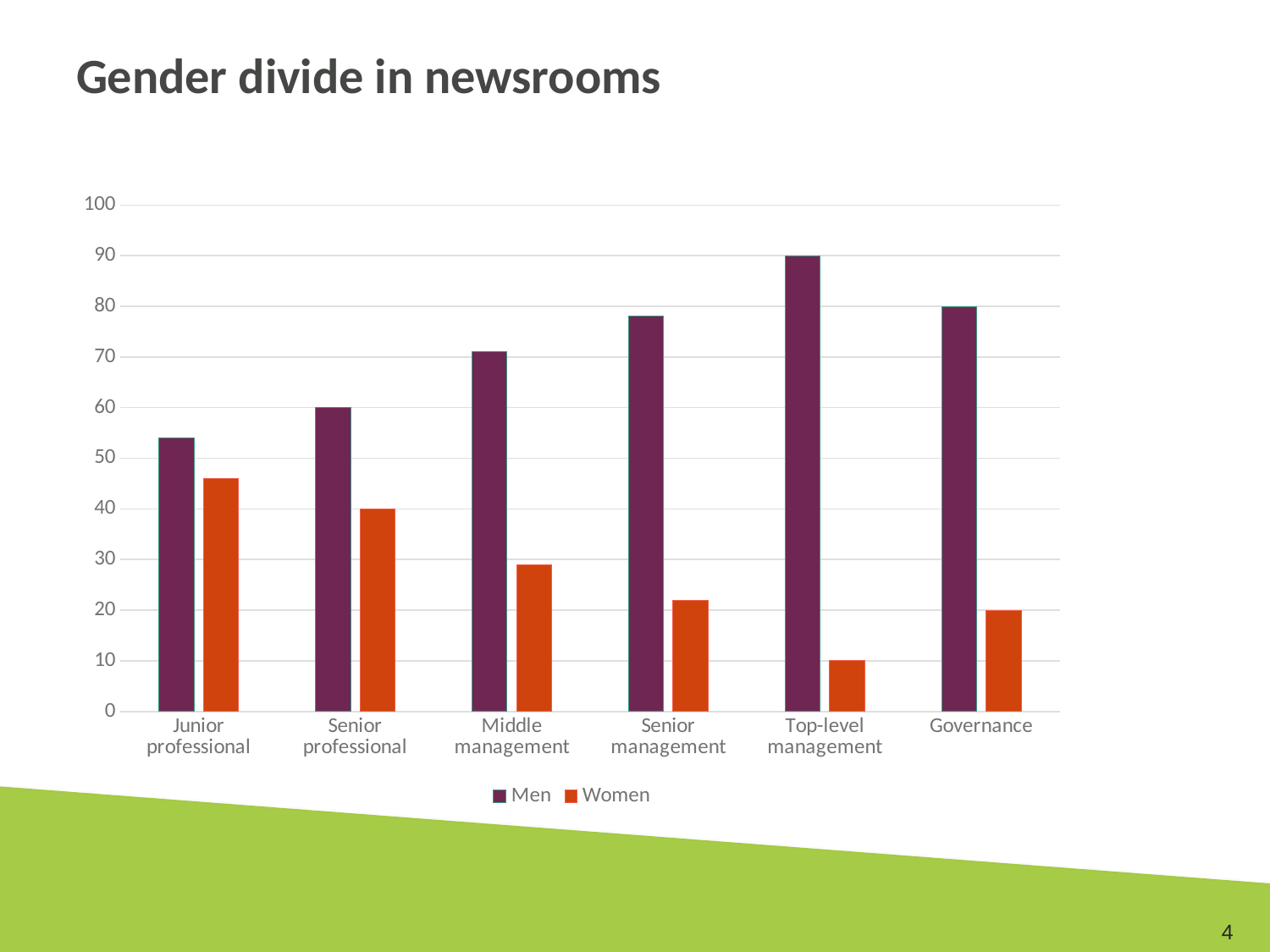
How many series does the legend list? 2 Which category has the highest value for Men? Top-level management Is the value for Women in Senior management greater or less than 30? less What kind of chart is shown on the slide? bar chart What is the value for Men in Senior professional? 60 Do the values for Women rise or fall from Junior professional to Top-level management? fall Which category has the lowest value for Women? Top-level management How many categories are shown on the x axis? 6 Which is larger in Governance, the value for Men or the value for Women? Men What is the value for Women in Top-level management? 10 Which category has the highest value for Women? Junior professional